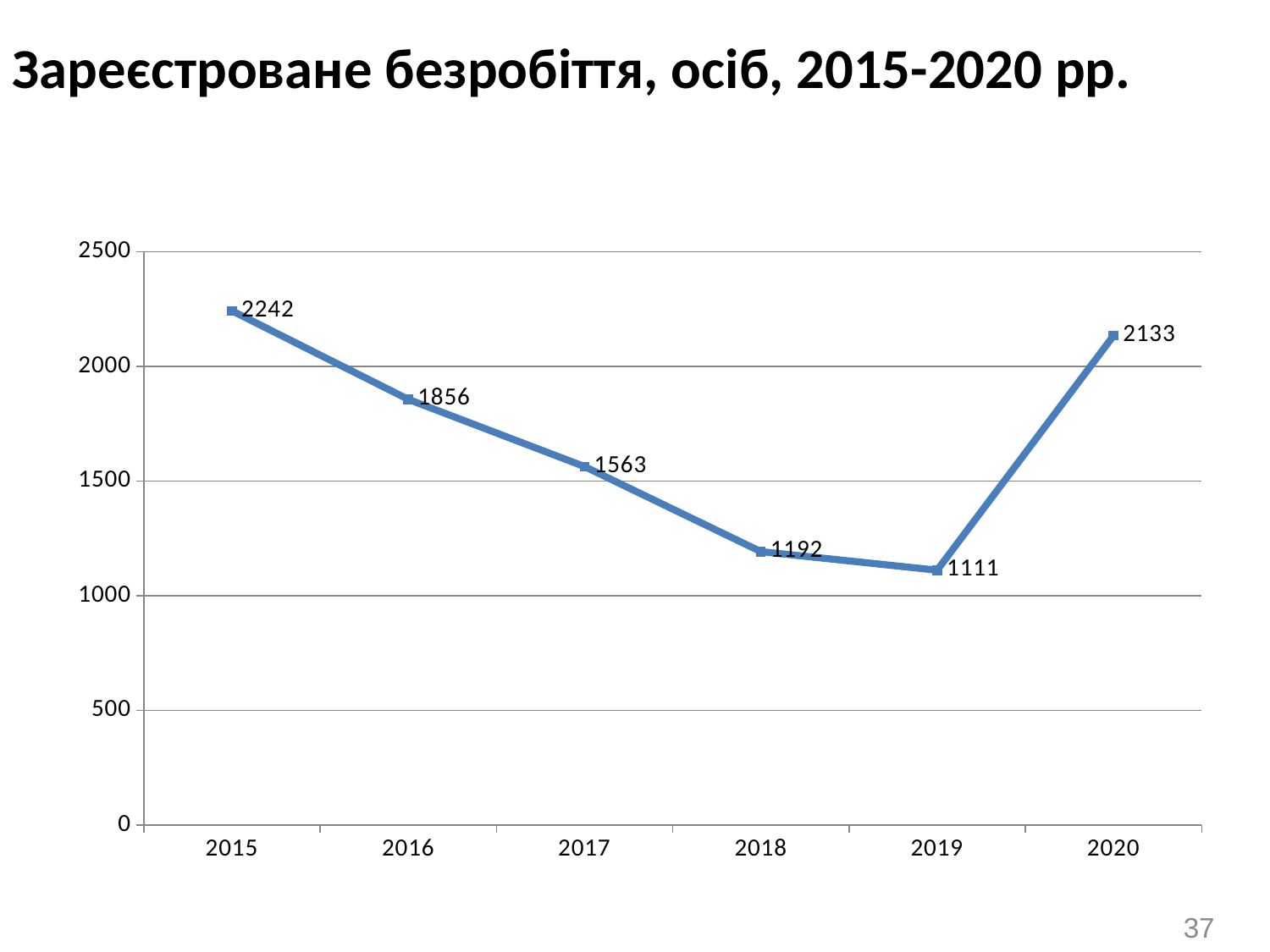
Which year has the lowest value? 2019 What is the difference between the values for 2020 and 2019? 1022 What is the value shown for 2020? 2133 What is the difference between the values for 2015 and 2016? 386 Which year has the highest value? 2015 Is the value for 2016 greater or less than 2000? less What is the registered unemployment value for 2015? 2242 How many years are plotted on the chart? 6 Which is larger, the value for 2017 or the value for 2018? 2017 What is the value shown for 2019? 1111 What kind of chart is shown on the slide? line chart Do the values rise or fall from 2015 to 2019? fall